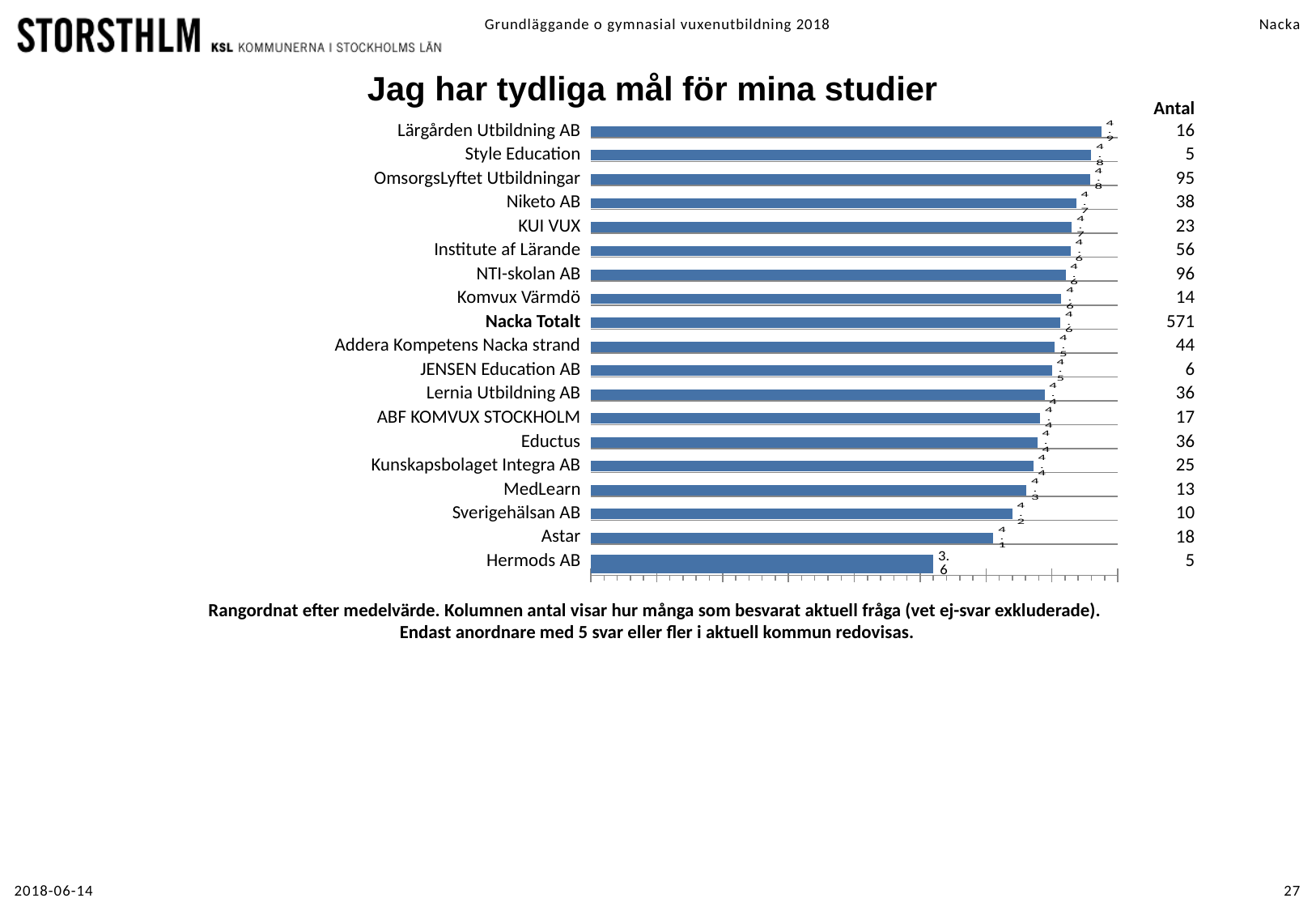
What is the title of the chart? Jag har tydliga mål för mina studier Do the bar values increase or decrease going from the top of the chart to the bottom? decrease What is the difference between the values for Lärgården Utbildning AB and Hermods AB? 1.3 Which provider has the lowest value in the chart? Hermods AB What is the value shown for Hermods AB? 3.6 What kind of chart is shown on the slide? bar chart Which provider has the highest value in the chart? Lärgården Utbildning AB How many providers (bars) are shown in the chart? 19 What is the value shown for MedLearn? 4.3 Which has a larger value, Astar or Hermods AB? Astar What is the value shown for Lärgården Utbildning AB? 4.9 What is the value shown for Nacka Totalt? 4.6